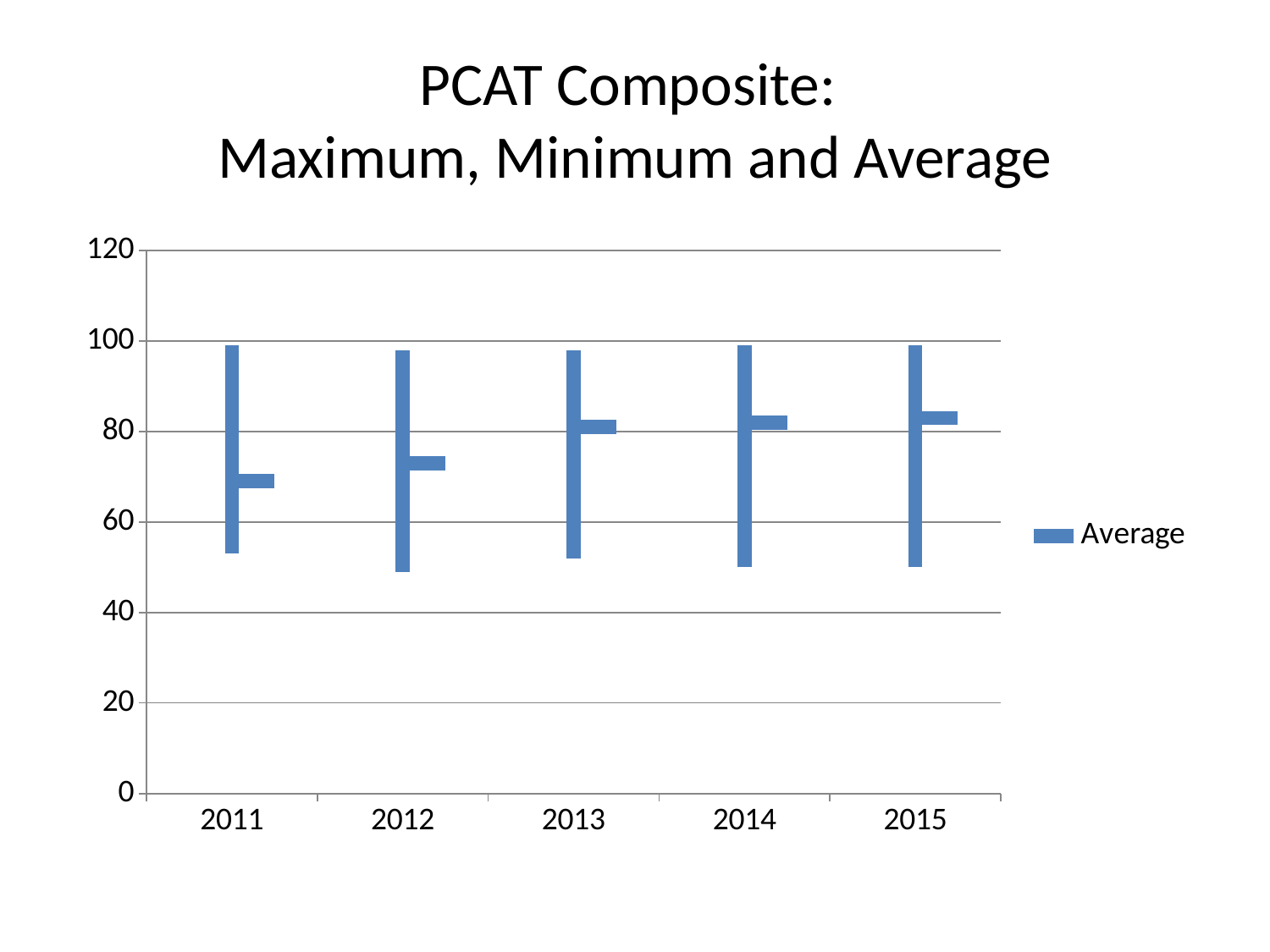
How many series does the legend list? 1 How many years are shown on the x axis of the chart? 5 Is the Average value for 2015 greater or less than 80? greater Is the Average value for 2011 greater or less than 60? greater What is the title of the chart? PCAT Composite: Maximum, Minimum and Average Does the Average value rise or fall from 2011 to 2015? rise Is the Average value for 2011 greater or less than 80? less What is the name of the series listed in the legend? Average